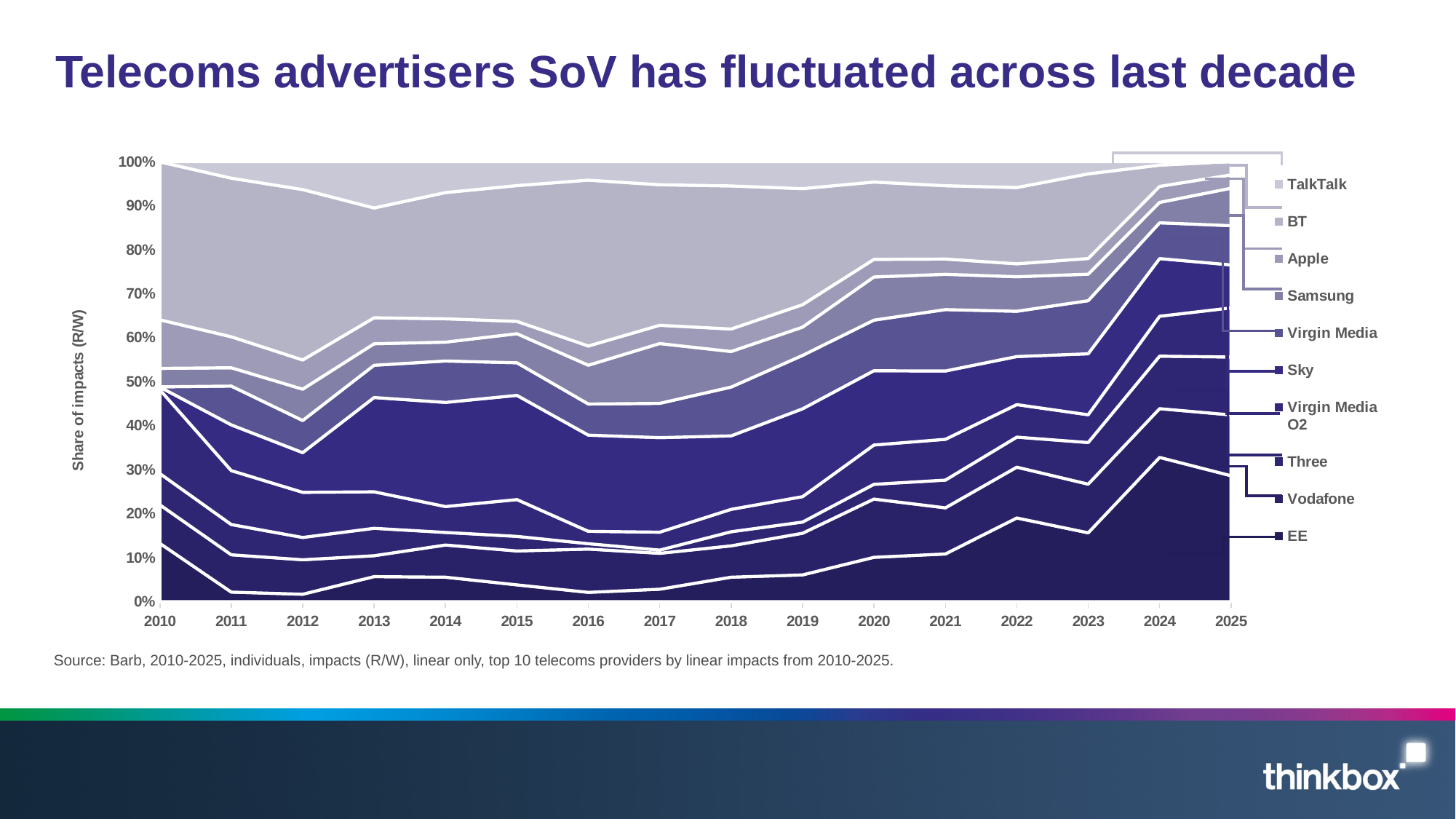
Is the share for EE in 2010 greater or less than 10%? greater Which is larger, EE's share in 2024 or EE's share in 2012? 2024 Is the share for EE in 2024 greater or less than 30%? greater How many years are plotted along the x axis? 16 Is the share for EE in 2016 greater or less than 10%? less Does EE's share rise or fall between 2021 and 2024? rise What is the label on the y axis? Share of impacts (R/W) How many series does the legend list? 10 What kind of chart is shown on the slide? Stacked area chart What is the first year shown on the x axis? 2010 In which year is EE's share at its highest? 2024